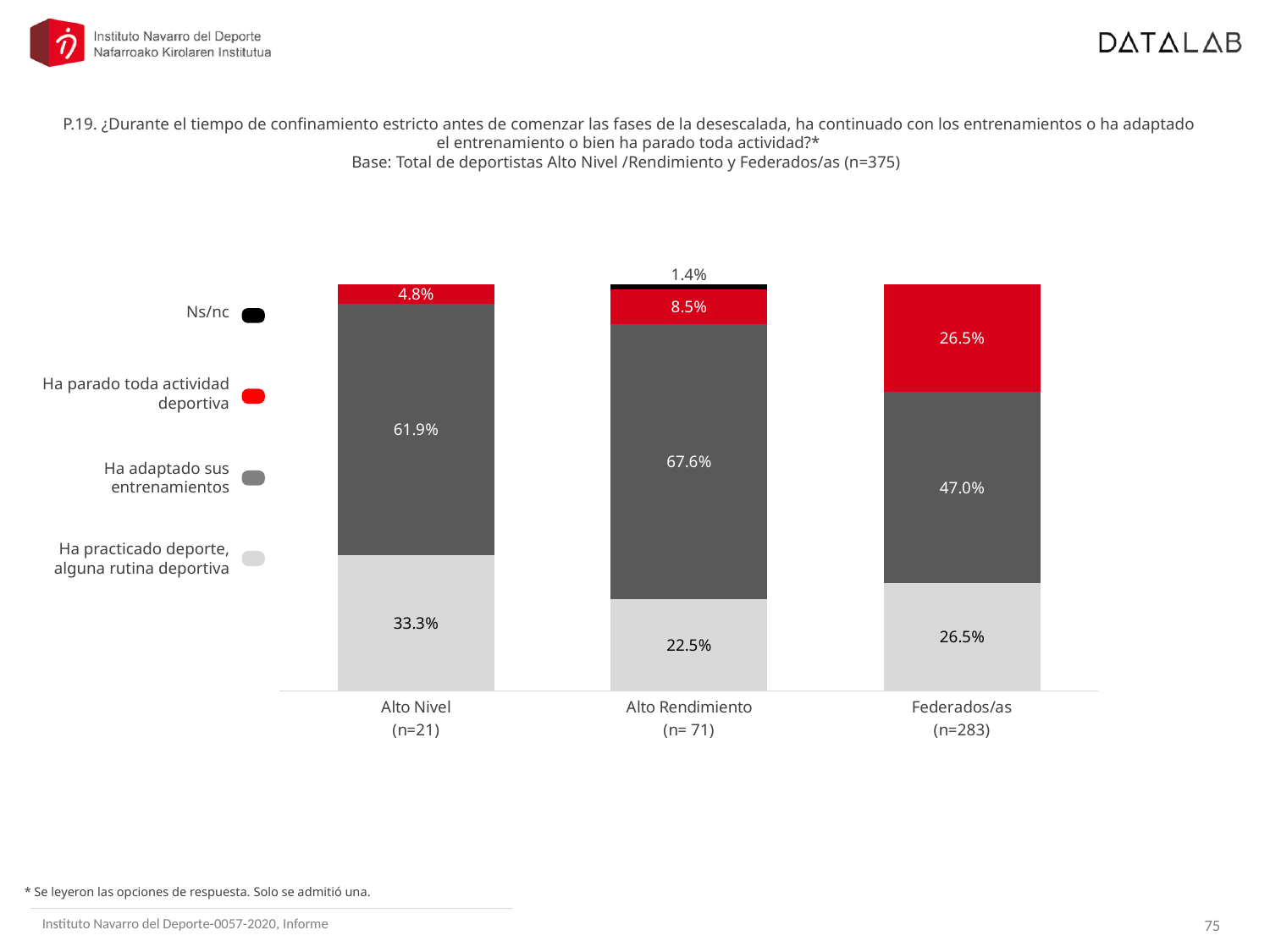
Which is larger: the 'Ha practicado deporte, alguna rutina deportiva' value for Alto Nivel or for Federados/as? Alto Nivel What is the Ns/nc value for Alto Rendimiento? 1.4% What percentage of Federados/as 'Ha parado toda actividad deportiva'? 26.5% What is the difference between the 'Ha adaptado sus entrenamientos' values for Alto Rendimiento and Federados/as? 20.6 percentage points What percentage of Alto Rendimiento athletes 'Ha practicado deporte, alguna rutina deportiva'? 22.5% What percentage of Alto Nivel athletes 'Ha adaptado sus entrenamientos'? 61.9% How many groups (bars) are shown on the x axis? 3 What kind of chart is shown on the slide? Stacked bar chart Which colour represents 'Ha parado toda actividad deportiva' in the legend? Red Which group has the highest share for 'Ha adaptado sus entrenamientos'? Alto Rendimiento Which group has the lowest share for 'Ha parado toda actividad deportiva'? Alto Nivel How many series does the legend list? 4